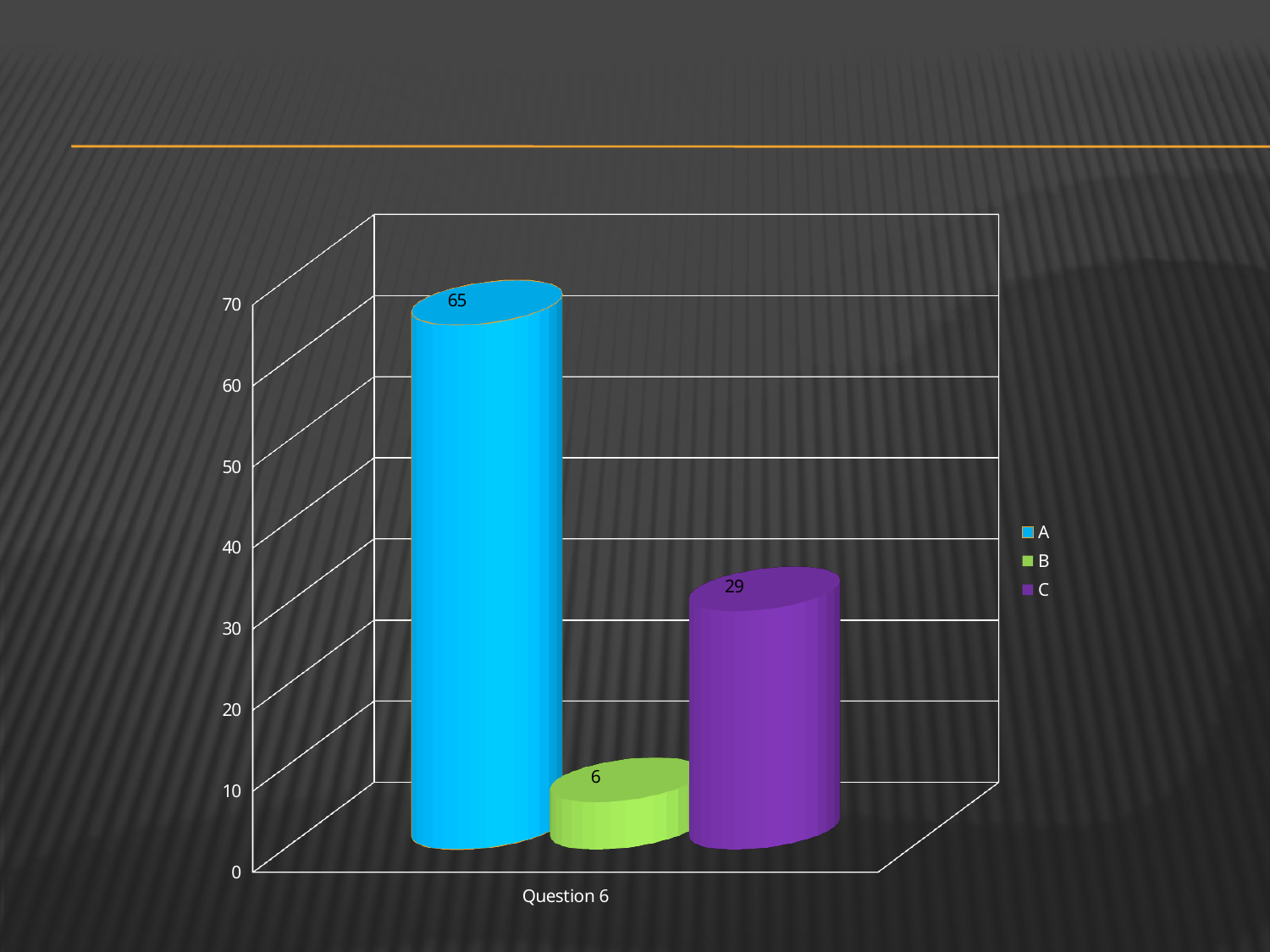
What kind of chart is shown on the slide? Bar chart What is the value for series C for Question 6? 29 What is the difference between the values for series A and series C? 36 Which is larger, the value for series C or the value for series B? C What is the difference between the values for series C and series B? 23 Which series has the lowest value for Question 6? B How many series does the legend list? 3 Is the value for series A greater or less than 60? greater Which series has the highest value for Question 6? A What is the value for series A for Question 6? 65 What is the category label shown on the x axis? Question 6 What is the value for series B for Question 6? 6